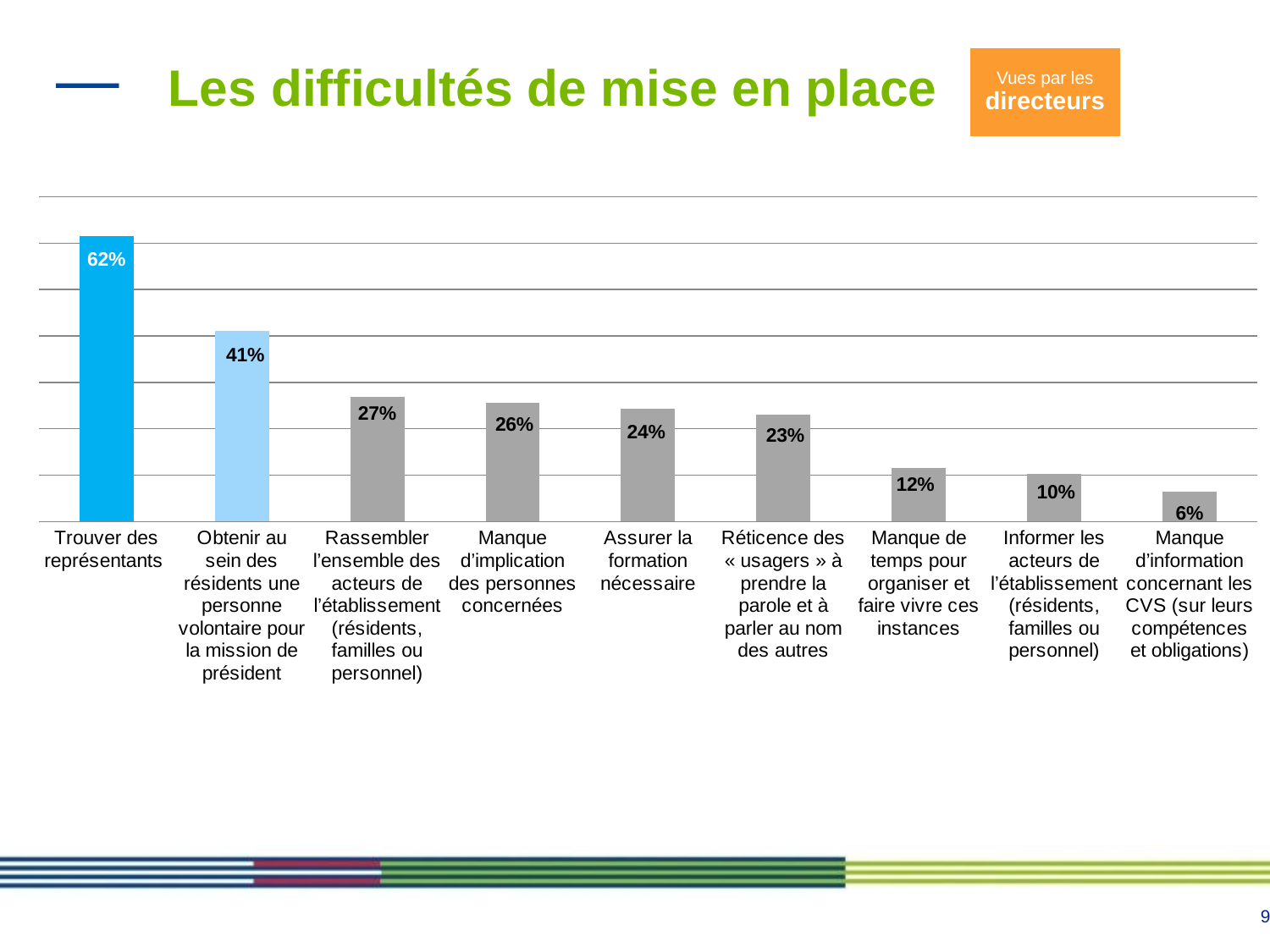
What is the value for "Assurer la formation nécessaire"? 24% What is the title of the slide containing the chart? Les difficultés de mise en place Which category has the highest value? Trouver des représentants Do the values rise or fall from left to right across the categories? Fall What is the value for "Trouver des représentants"? 62% What is the value for "Manque de temps pour organiser et faire vivre ces instances"? 12% What is the difference between "Trouver des représentants" and "Obtenir au sein des résidents une personne volontaire pour la mission de président"? 21% Which category has the lowest value? Manque d'information concernant les CVS (sur leurs compétences et obligations) Which is larger: "Obtenir au sein des résidents une personne volontaire pour la mission de président" or "Réticence des « usagers » à prendre la parole et à parler au nom des autres"? Obtenir au sein des résidents une personne volontaire pour la mission de président How many categories are shown in the chart? 9 What is the difference between "Rassembler l'ensemble des acteurs de l'établissement" and "Informer les acteurs de l'établissement"? 17% What kind of chart is shown on the slide? Bar chart